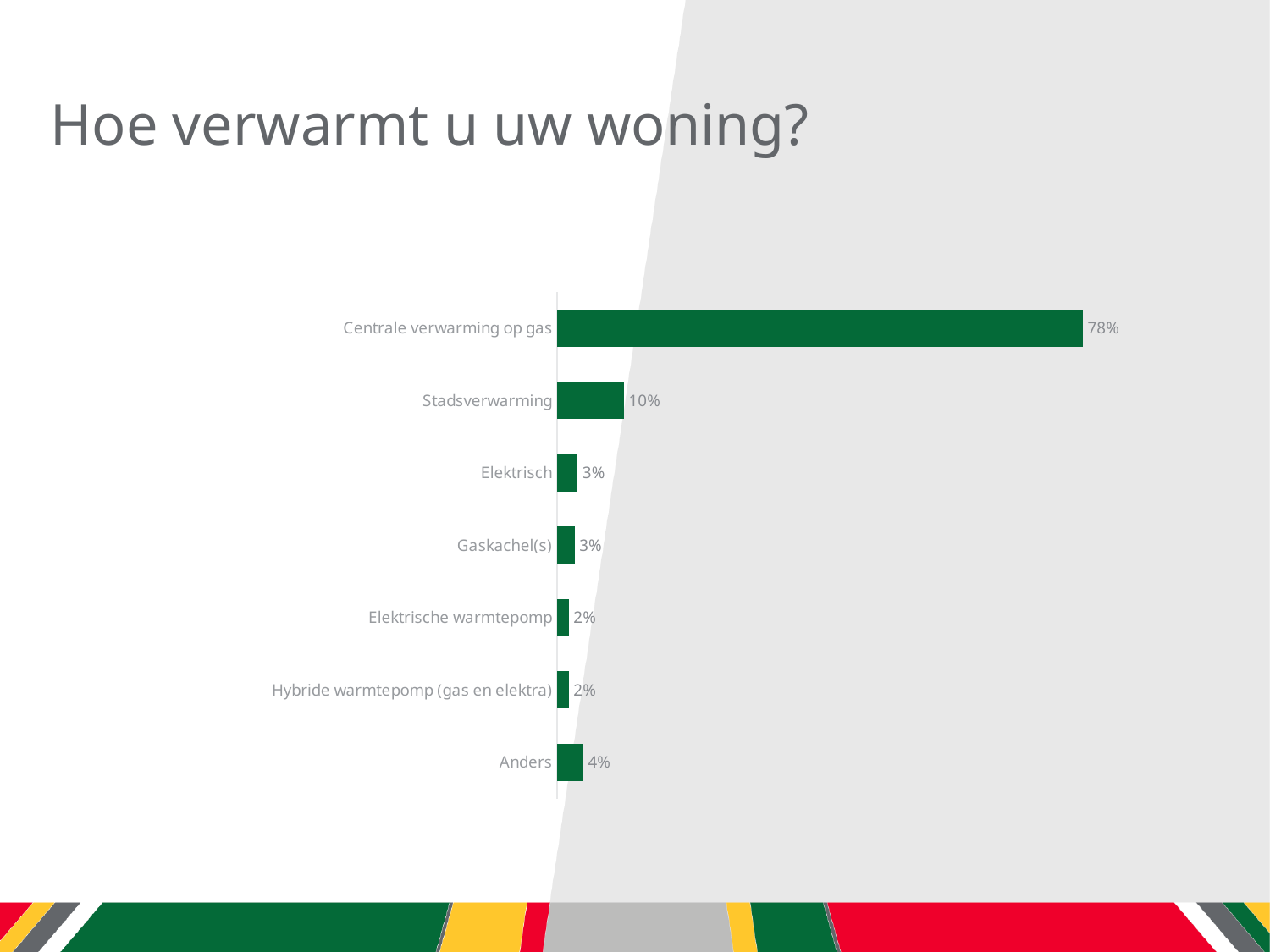
What percentage of respondents heat their home with 'Centrale verwarming op gas'? 78% How many categories are shown in the chart? 7 What is the difference between the values for 'Centrale verwarming op gas' and 'Stadsverwarming'? 68% Which category has the highest value? Centrale verwarming op gas What is the value shown for 'Stadsverwarming'? 10% What is the title of the slide? Hoe verwarmt u uw woning? What is the difference between the values for 'Anders' and 'Elektrisch'? 1% What colour are the bars in the chart? Green What is the value shown for 'Elektrische warmtepomp'? 2% Which is larger, the value for 'Stadsverwarming' or the value for 'Anders'? Stadsverwarming What kind of chart is shown on the slide? Bar chart What is the value shown for 'Anders'? 4%